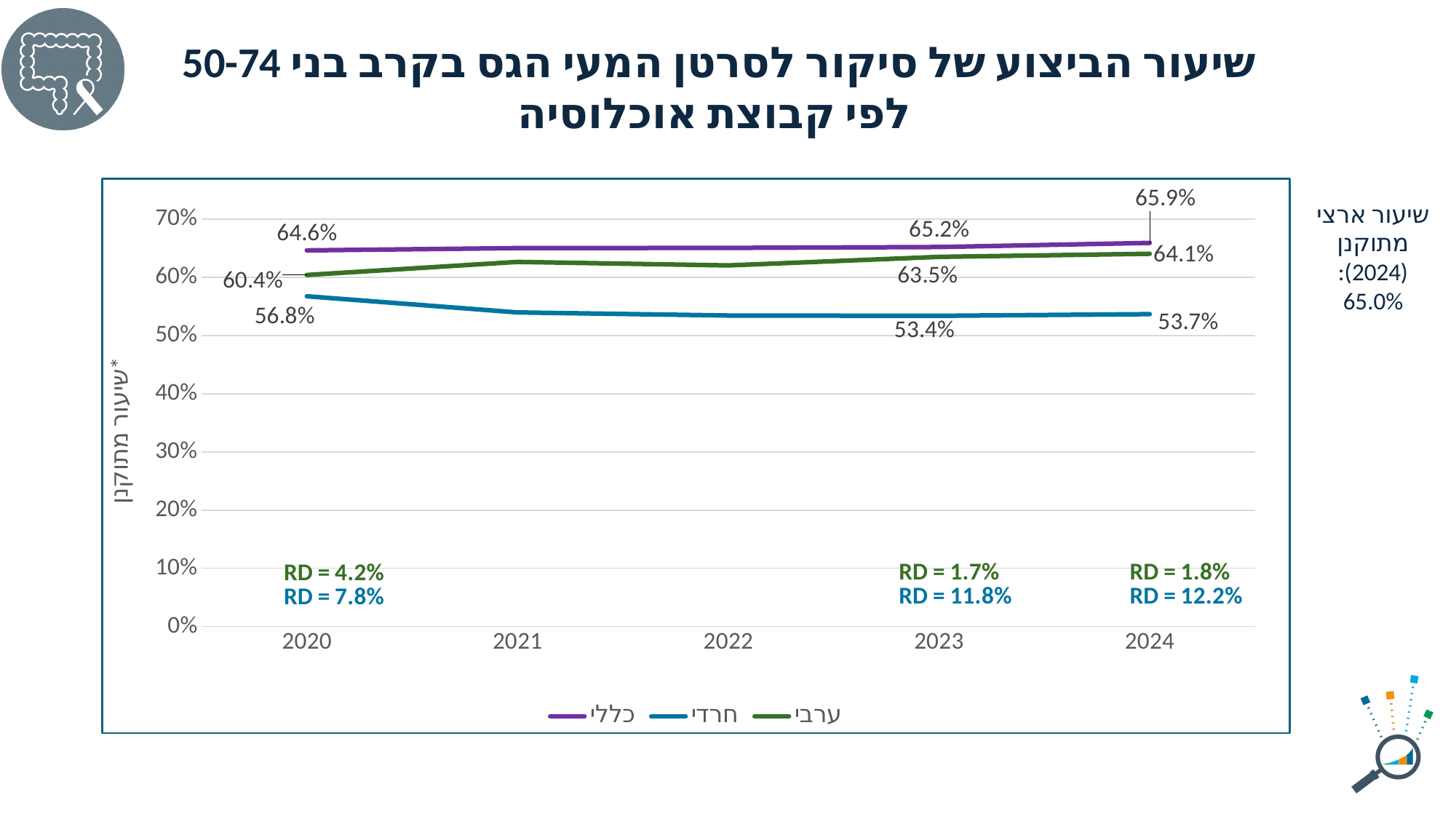
Is the value for the חרדי series in 2022 greater or less than 60%? less How many series does the legend list? 3 How many years are shown on the x axis? 5 Does the ערבי series rise or fall from 2020 to 2024? rise Which series has the lowest value in 2024? חרדי What is the difference between the כללי and חרדי values in 2024? 12.2% What is the value for the כללי series in 2024? 65.9% What is the value for the חרדי series in 2020? 56.8% What is the value for the ערבי series in 2023? 63.5% Which series has the highest value in 2020? כללי What type of chart is shown on the slide? line chart Which is larger in 2023: the ערבי value or the חרדי value? ערבי